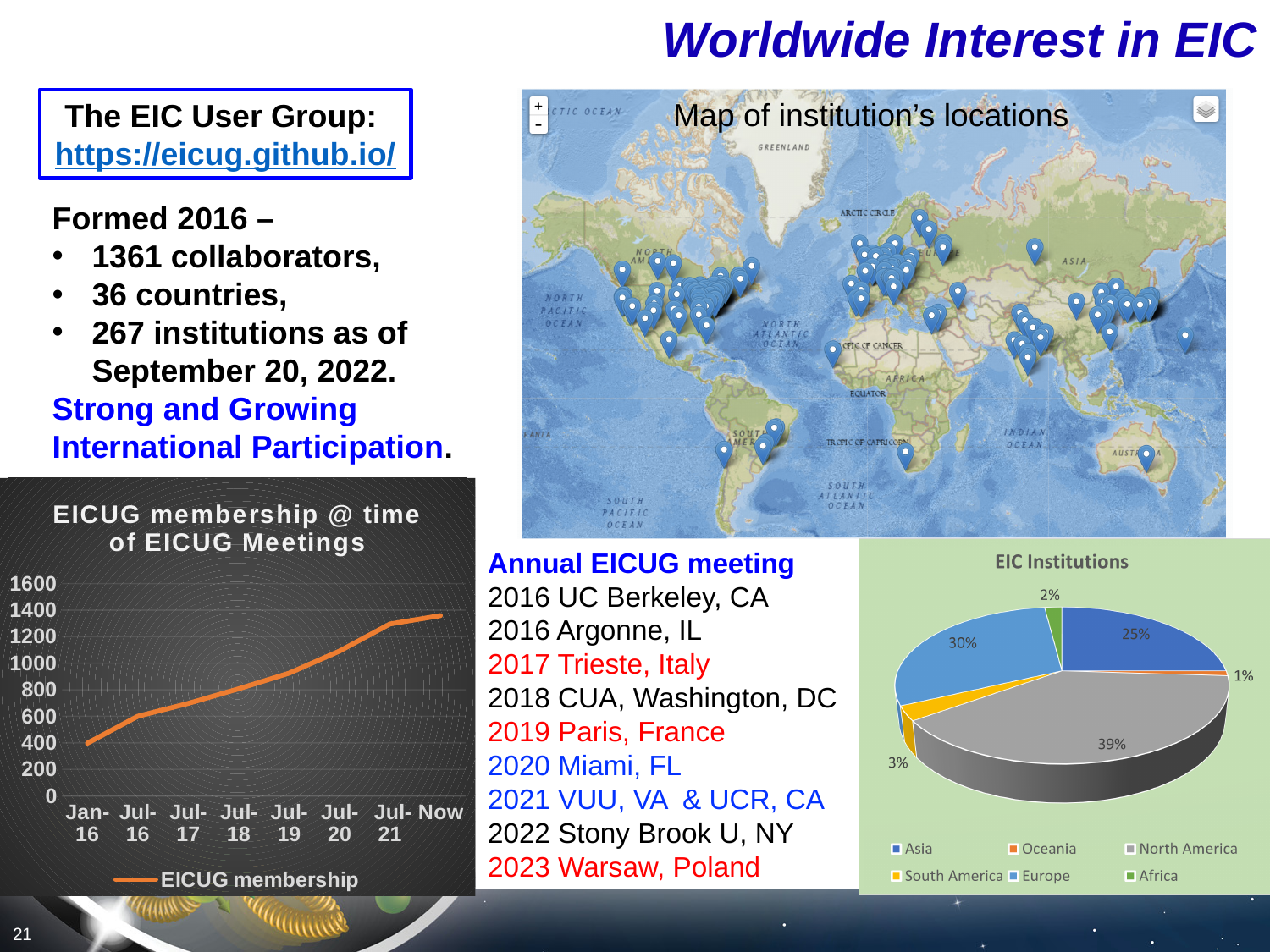
In the 'EIC Institutions' pie chart, which region has the largest share? North America In the 'EICUG membership @ time of EICUG Meetings' chart, is the value for Jul-20 greater or less than 1000? greater In the 'EICUG membership @ time of EICUG Meetings' chart, is the value for Jan-16 greater or less than 600? less In the 'EIC Institutions' pie chart, what is the difference between the North America share and the Europe share? 9% What kind of chart is 'EICUG membership @ time of EICUG Meetings'? Line chart How many regions does the legend of the 'EIC Institutions' pie chart list? 6 In the 'EIC Institutions' pie chart, which region has the smallest share? Oceania In the 'EICUG membership @ time of EICUG Meetings' chart, do the values rise or fall from Jan-16 to Now? Rise In the 'EIC Institutions' pie chart, what share of institutions is in Asia? 25% In the 'EIC Institutions' pie chart, what share of institutions is in Europe? 30% In the 'EIC Institutions' pie chart, which is larger, the share for Asia or the share for Europe? Europe In the 'EIC Institutions' pie chart, what share of institutions is in North America? 39%